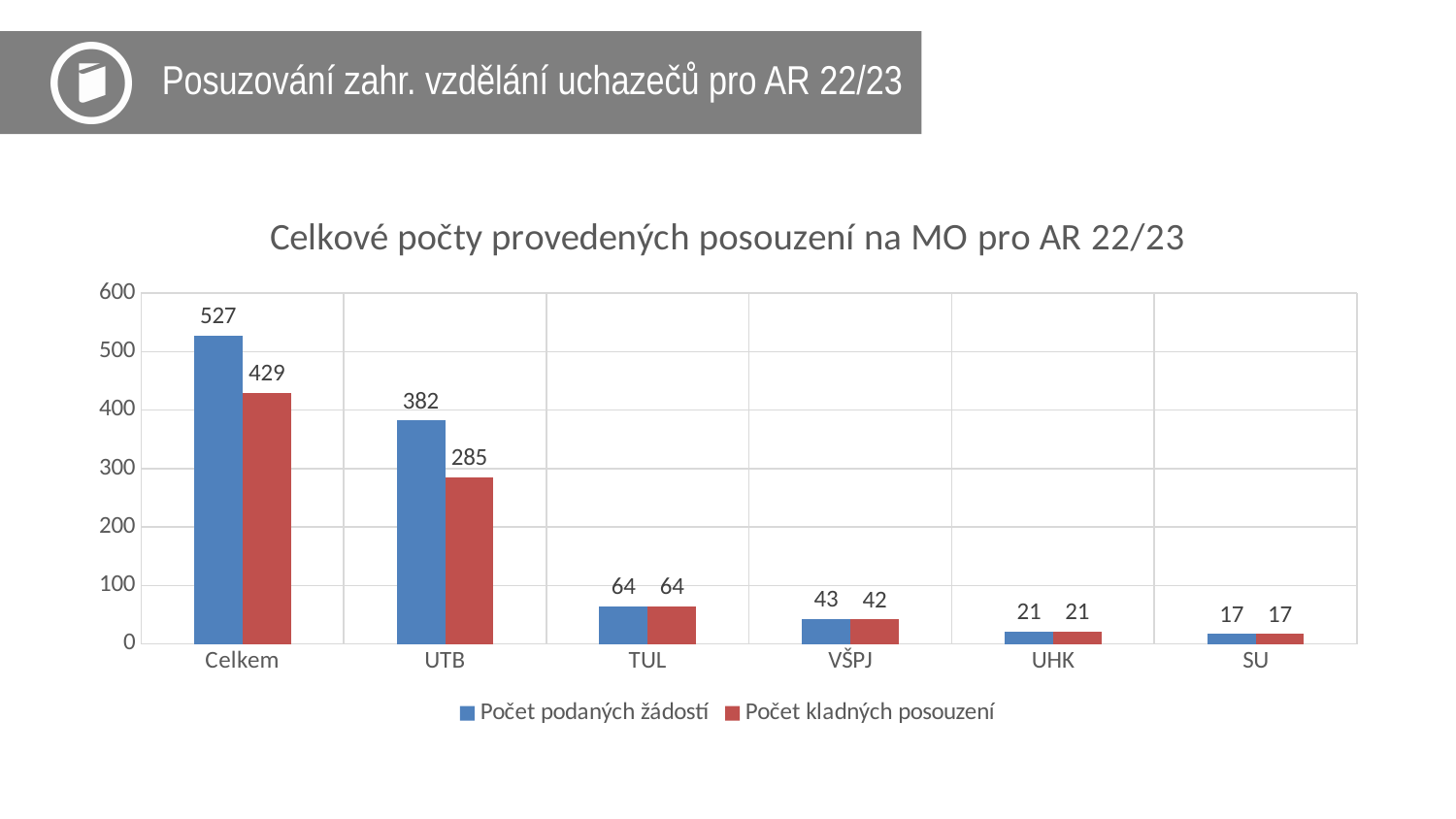
What is the value of Počet kladných posouzení for Celkem? 429 What is the value of Počet podaných žádostí for UTB? 382 How many series does the legend list? 2 Which category has the highest value for Počet podaných žádostí? Celkem What kind of chart is shown on the slide? Bar chart What is the title of the chart? Celkové počty provedených posouzení na MO pro AR 22/23 What is the difference between Počet podaných žádostí and Počet kladných posouzení for Celkem? 98 How many categories are shown on the x axis? 6 Which category has the lowest value for Počet kladných posouzení? SU What is the difference between Počet podaných žádostí and Počet kladných posouzení for UTB? 97 Which is larger: Počet podaných žádostí for TUL or Počet podaných žádostí for VŠPJ? TUL What is the value of Počet kladných posouzení for VŠPJ? 42